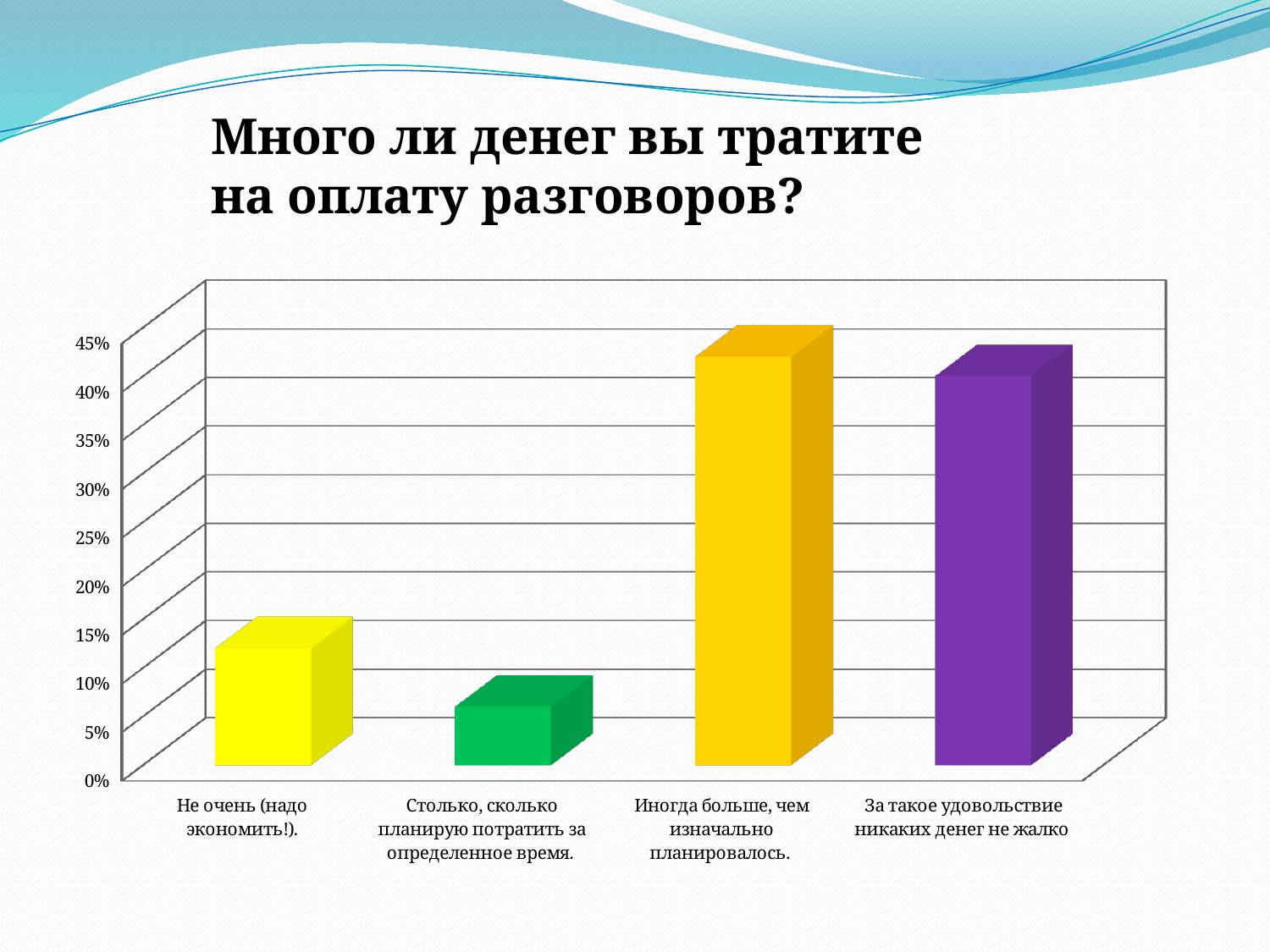
Is the value for "Столько, сколько планирую потратить за определенное время." greater or less than 10%? less Is the value for "Иногда больше, чем изначально планировалось." greater or less than 45%? less Which is larger: the value for "Иногда больше, чем изначально планировалось." or the value for "Не очень (надо экономить!)."? Иногда больше, чем изначально планировалось. What is the title of the chart on the slide? Много ли денег вы тратите на оплату разговоров? How many categories are shown on the x axis of the chart? 4 Is the value for "Не очень (надо экономить!)." greater or less than 15%? less Which is larger: the value for "Не очень (надо экономить!)." or the value for "Столько, сколько планирую потратить за определенное время."? Не очень (надо экономить!). Which category has the lowest value in the chart? Столько, сколько планирую потратить за определенное время. What kind of chart is shown on the slide? bar chart